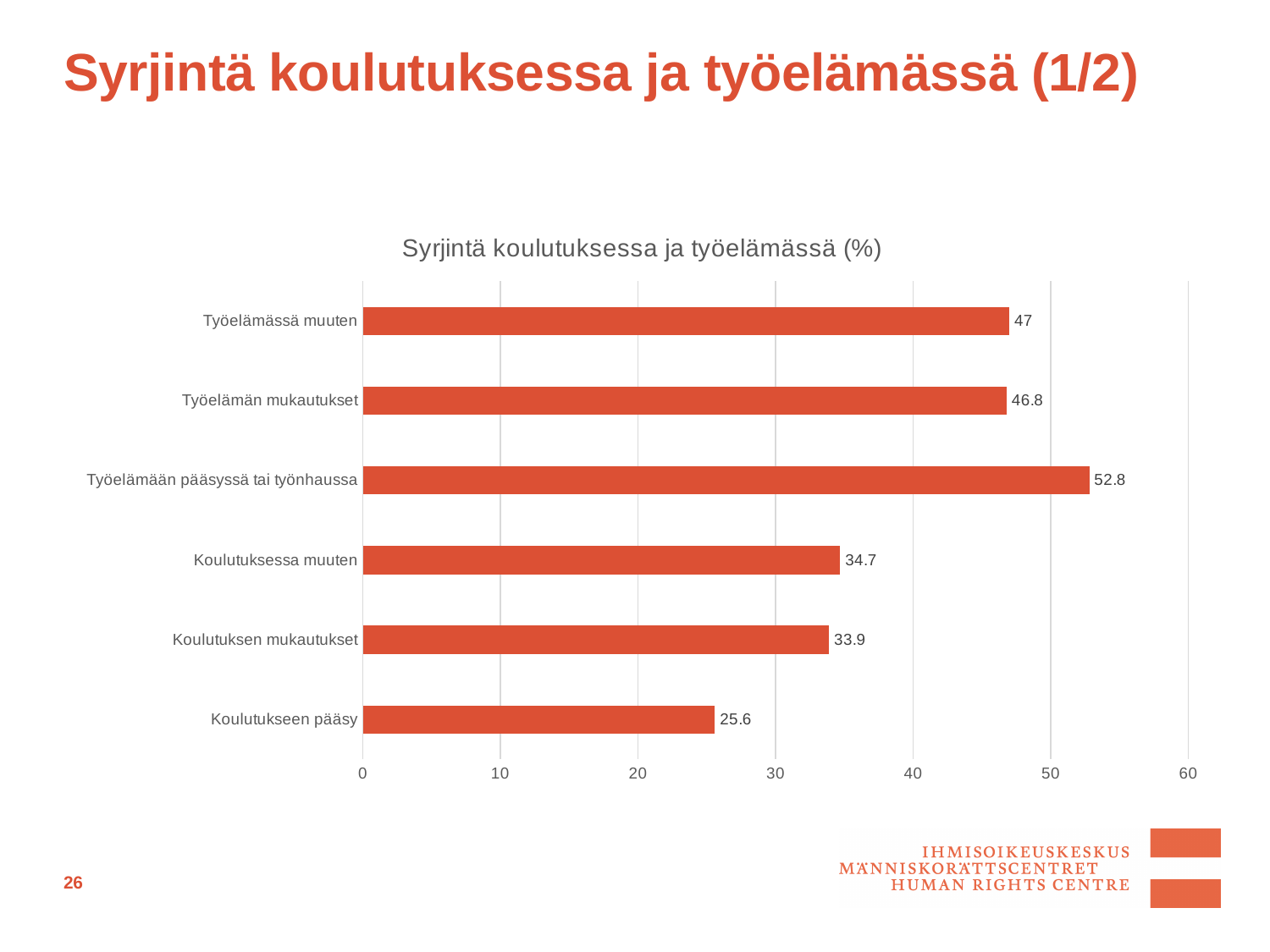
How many categories are shown in the chart? 6 Is the value for Työelämän mukautukset greater or less than 40? greater What is the value for Työelämään pääsyssä tai työnhaussa? 52.8 What kind of chart is shown on the slide? Bar chart What is the value for Koulutuksen mukautukset? 33.9 Which category has the highest value? Työelämään pääsyssä tai työnhaussa What is the title of the chart? Syrjintä koulutuksessa ja työelämässä (%) Which is larger, the value for Koulutuksessa muuten or the value for Koulutuksen mukautukset? Koulutuksessa muuten Which category has the lowest value? Koulutukseen pääsy What is the difference between the values for Työelämässä muuten and Koulutuksessa muuten? 12.3 What is the value for Koulutukseen pääsy? 25.6 What is the maximum value shown on the horizontal axis? 60